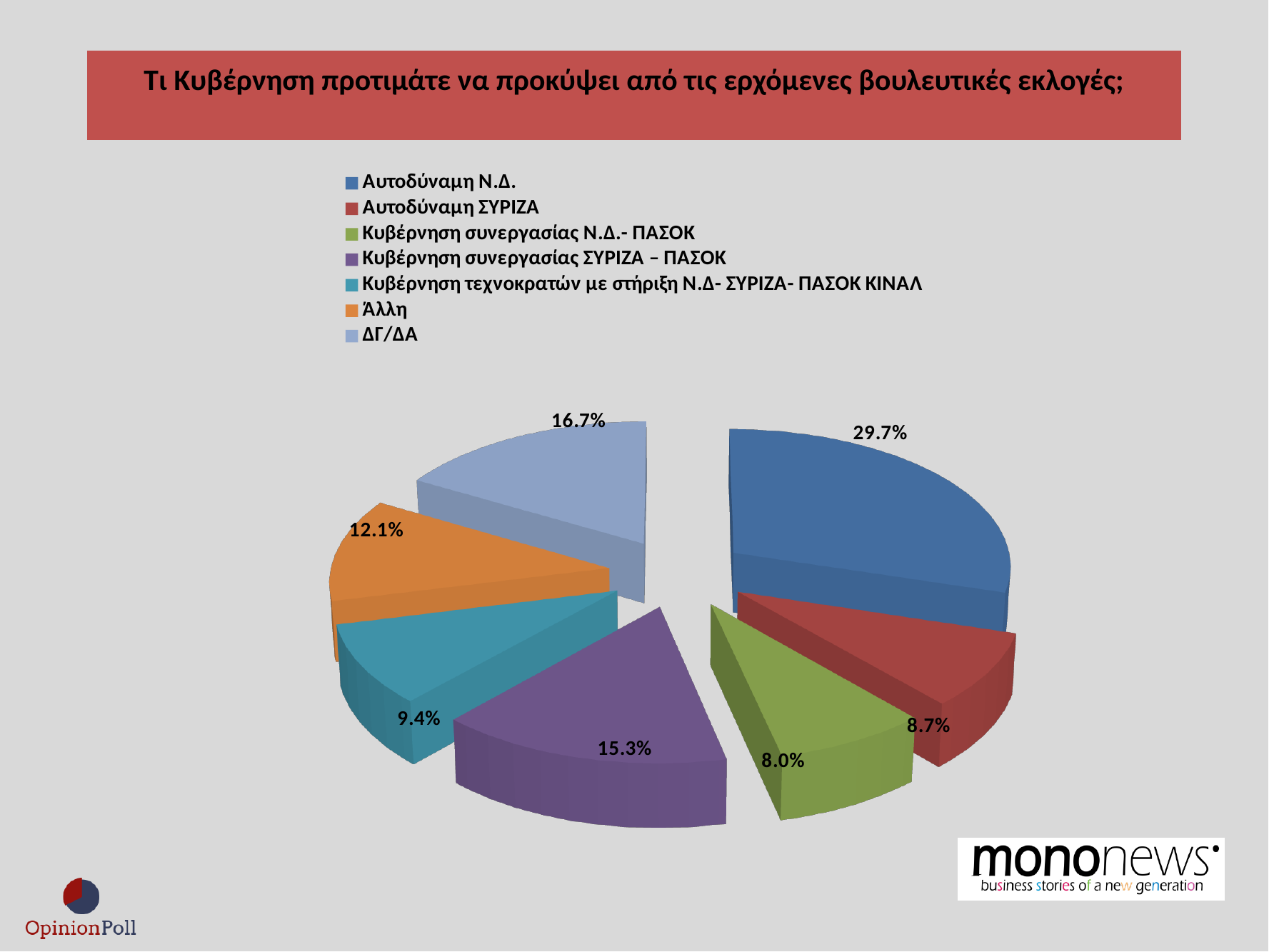
How many slices does the pie chart have? 7 What is the difference in percentage points between Αυτοδύναμη Ν.Δ. and Αυτοδύναμη ΣΥΡΙΖΑ? 21.0% Which option has the smallest share of the pie? Κυβέρνηση συνεργασίας Ν.Δ.- ΠΑΣΟΚ What type of chart is shown on the slide? Pie chart What percentage is shown for Άλλη? 12.1% What colour is the slice for Κυβέρνηση συνεργασίας Ν.Δ.- ΠΑΣΟΚ? Green What percentage is shown for Αυτοδύναμη ΣΥΡΙΖΑ? 8.7% Which option has the largest share of the pie? Αυτοδύναμη Ν.Δ. Which is larger: the share for Άλλη or the share for Κυβέρνηση τεχνοκρατών με στήριξη Ν.Δ- ΣΥΡΙΖΑ- ΠΑΣΟΚ ΚΙΝΑΛ? Άλλη What share does the ΔΓ/ΔΑ slice have? 16.7% What percentage of respondents prefer Αυτοδύναμη Ν.Δ.? 29.7% What percentage is shown for Κυβέρνηση συνεργασίας ΣΥΡΙΖΑ – ΠΑΣΟΚ? 15.3%